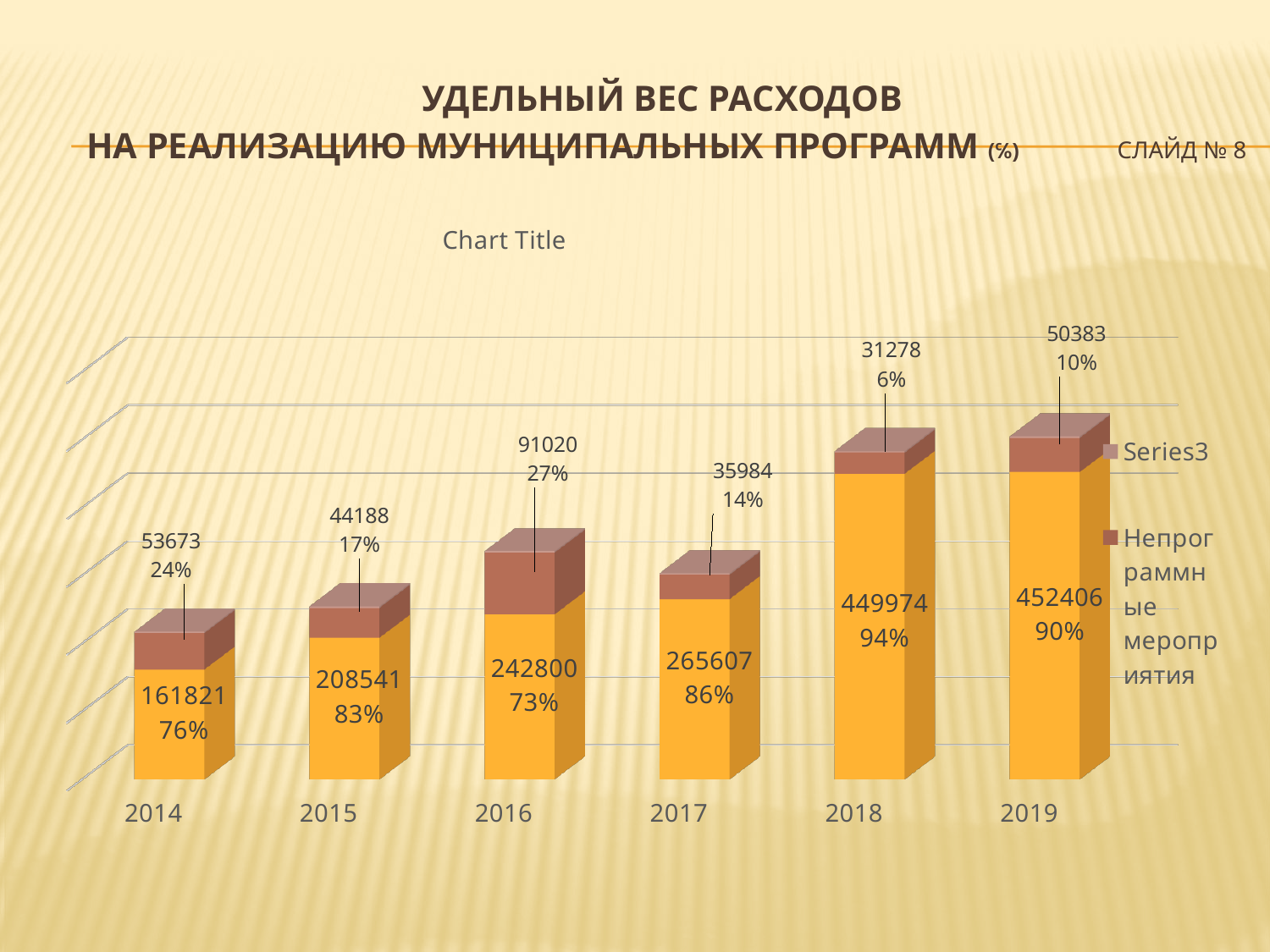
How many years are shown on the x axis? 6 Which year has the highest value for the yellow (lower) segment? 2019 How many entries does the legend list? 2 What kind of chart is shown on the slide? Stacked bar chart Which year has the lowest value for the brown (upper) segment? 2018 Which is larger: the brown segment value for 2016 or for 2017? 2016 What percentage is printed on the yellow (lower) segment of the bar for 2019? 90% What is the difference between the yellow segment values for 2019 and 2018? 2432 What is the total of the stacked bar for 2014? 215494 What value is printed on the yellow (lower) segment of the bar for 2014? 161821 What percentage is printed on the brown (upper) segment of the bar for 2016? 27% What value is printed on the brown (upper) segment of the bar for 2018? 31278